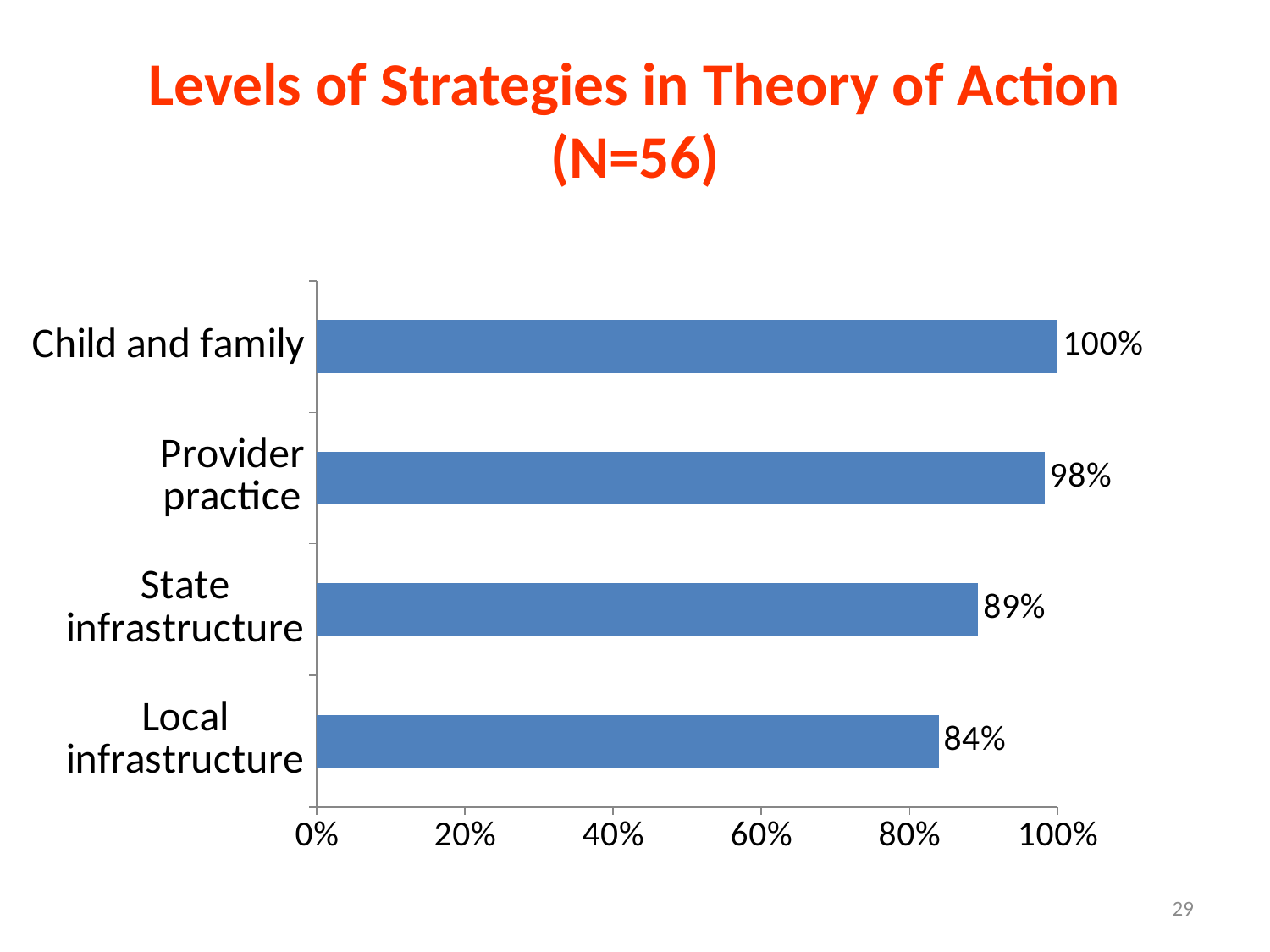
What is the value for Local infrastructure? 84% Which category has the highest value? Child and family What is the difference between the values for State infrastructure and Local infrastructure? 5% What is the value for Provider practice? 98% What is the value for Child and family? 100% How many categories are shown in the chart? 4 What is the value for State infrastructure? 89% Which is larger, the value for Provider practice or the value for State infrastructure? Provider practice Which category has the lowest value? Local infrastructure What is the difference between the values for Child and family and Local infrastructure? 16% Is the value for Local infrastructure greater or less than 80%? greater What kind of chart is shown on the slide? Bar chart